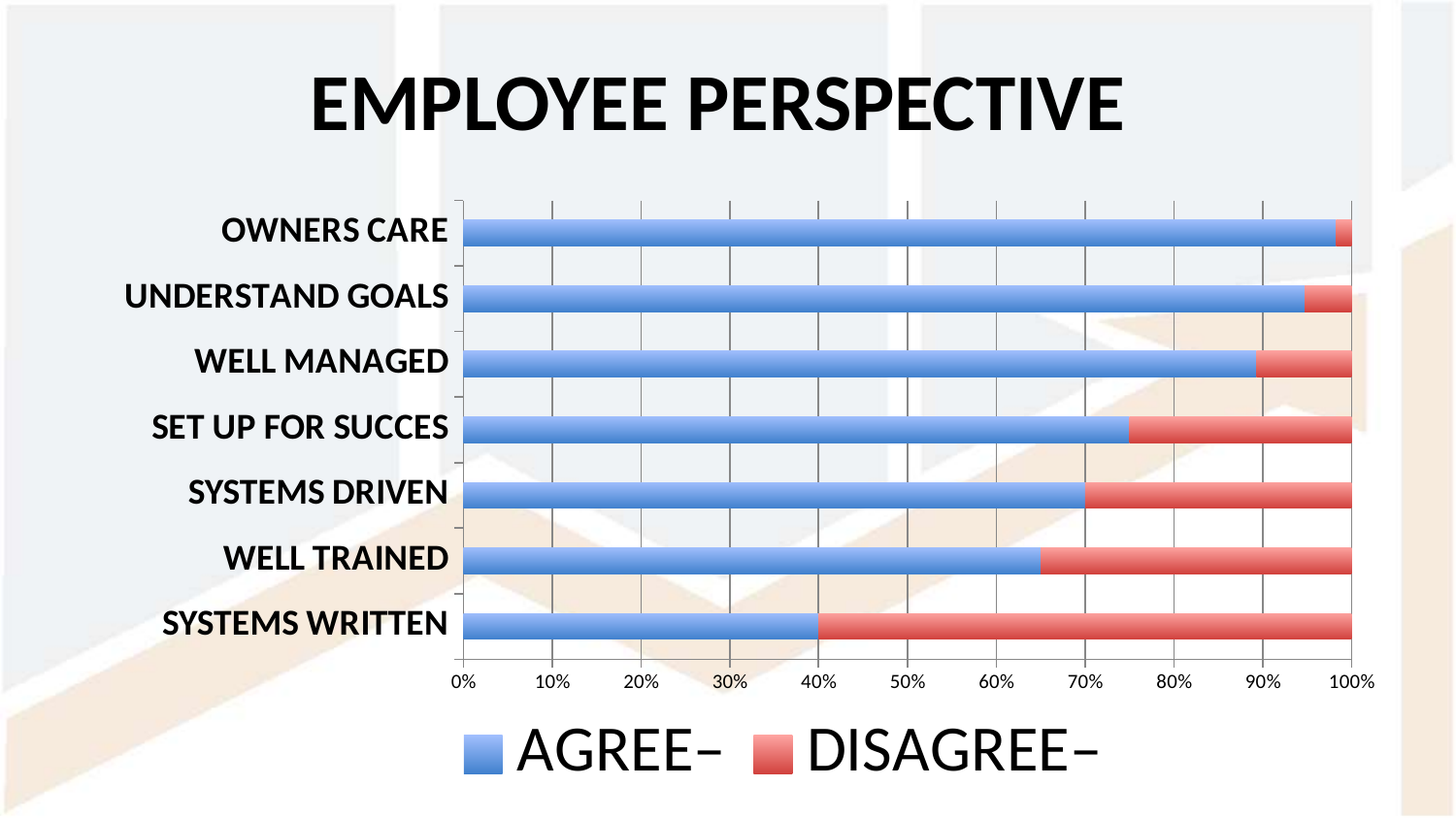
What is the AGREE value for SYSTEMS WRITTEN? 40% How many categories are plotted on the chart? 7 Which category has the lowest AGREE share? SYSTEMS WRITTEN Is the AGREE value for SET UP FOR SUCCES greater or less than 80%? less Which category has the largest DISAGREE share? SYSTEMS WRITTEN Which category has the highest AGREE share? OWNERS CARE Which has a larger AGREE share, WELL MANAGED or SYSTEMS DRIVEN? WELL MANAGED How many series does the legend list? 2 Is the AGREE value for WELL TRAINED greater or less than 60%? greater What colour represents the DISAGREE series? red What is the title of the chart? EMPLOYEE PERSPECTIVE What kind of chart is shown on the slide? bar chart